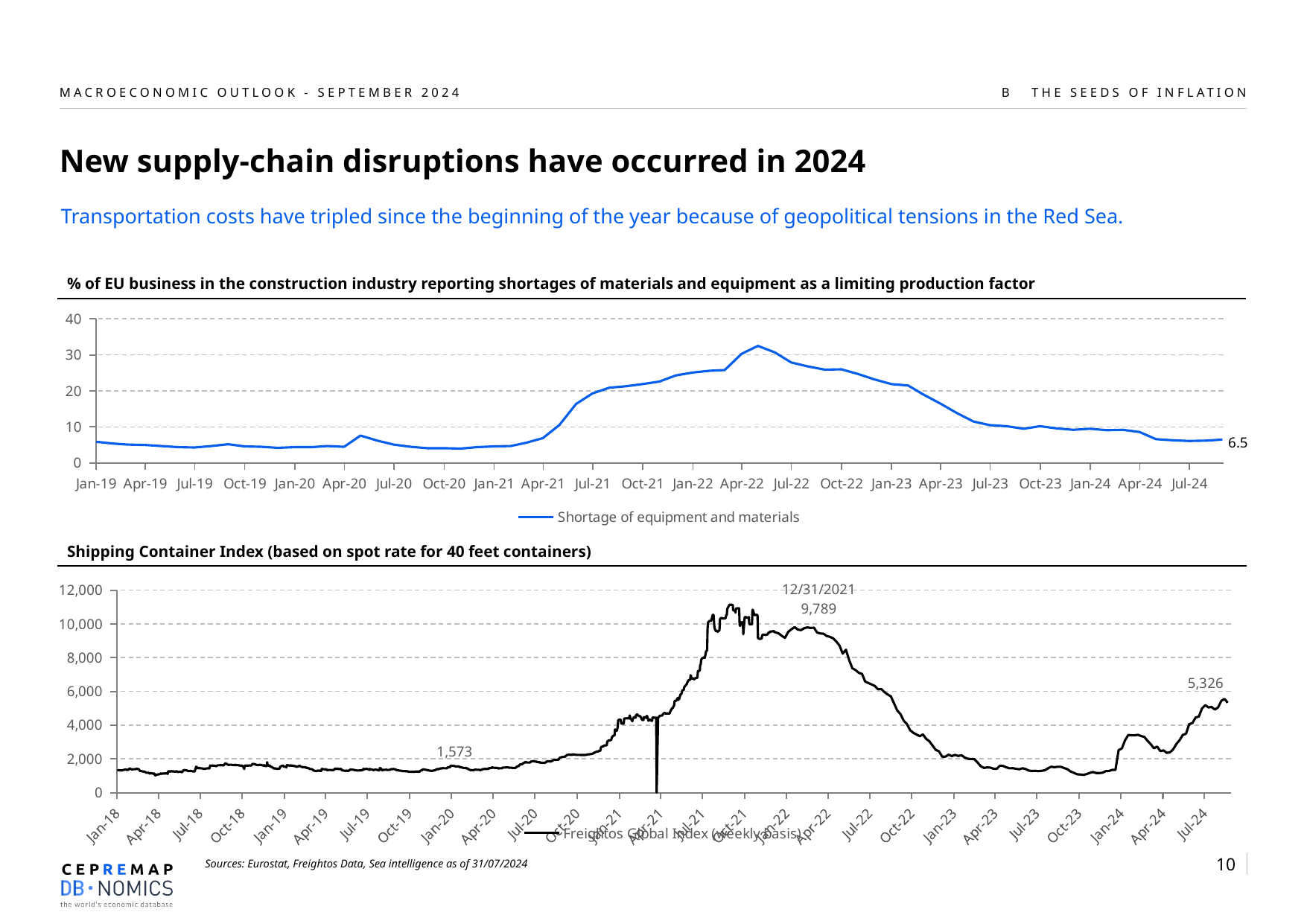
In the bottom chart (Shipping Container Index), which is larger: the value labelled 1,573 or the latest value labelled 5,326? 5,326 In the top chart (% of EU business in the construction industry reporting shortages), what kind of chart is shown? line chart In the bottom chart (Shipping Container Index), what value is labelled at the peak dated 12/31/2021? 9,789 In the top chart (% of EU business in the construction industry reporting shortages), what is the latest value labelled at the end of the line? 6.5 In the top chart (% of EU business in the construction industry reporting shortages), what is the legend entry for the line? Shortage of equipment and materials In the bottom chart (Shipping Container Index), does the index rise or fall between Jan-24 and Jul-24? rise In the bottom chart (Shipping Container Index), is the value at Oct-23 greater or less than 2,000? less In the top chart (% of EU business in the construction industry reporting shortages), how many series does the legend list? 1 In the top chart (% of EU business in the construction industry reporting shortages), is the value at Jan-20 greater or less than 10? less In the bottom chart (Shipping Container Index), what is the latest value labelled at the end of the line? 5,326 In the bottom chart (Shipping Container Index), what is the difference between the 12/31/2021 peak value and the latest labelled value? 4,463 In the top chart (% of EU business in the construction industry reporting shortages), is the value at Oct-22 greater or less than 20? greater